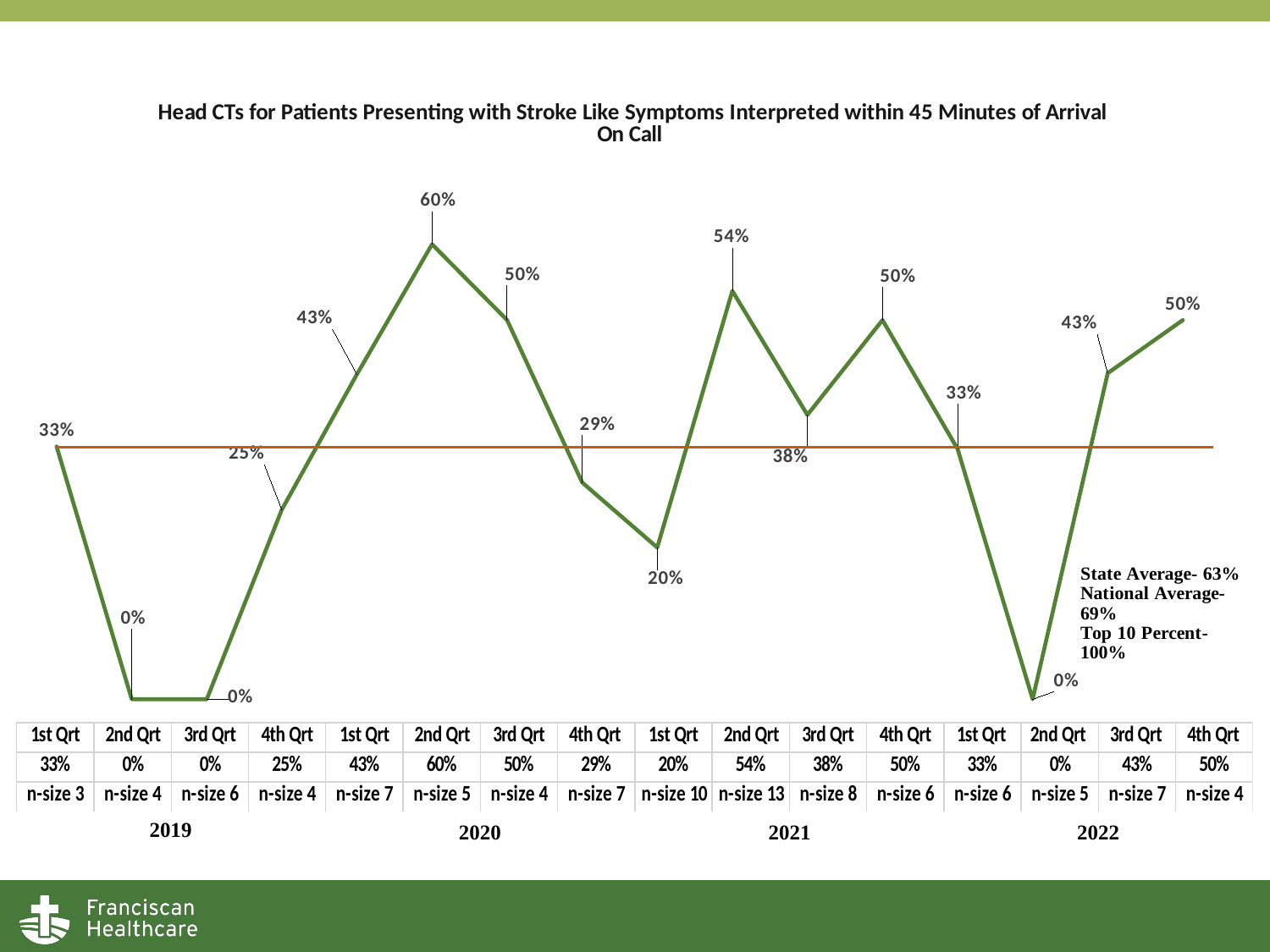
Which is larger, the value for the 4th Qrt of 2019 or the value for the 4th Qrt of 2020? 4th Qrt of 2020 What type of chart is shown on the slide? line chart Do the values rise or fall from the 1st Qrt of 2020 to the 2nd Qrt of 2020? rise What is the n-size for the 2nd Qrt of 2021? n-size 13 Which quarter has the highest value on the chart? 2nd Qrt 2020 What is the value for the 3rd Qrt of 2022? 43% How many quarterly data points are plotted on the chart? 16 What is the State Average shown in the text box on the chart? 63% What is the value for the 2nd Qrt of 2020? 60% What is the difference between the 2nd Qrt 2021 value and the 3rd Qrt 2021 value? 16% What is the title of the chart? Head CTs for Patients Presenting with Stroke Like Symptoms Interpreted within 45 Minutes of Arrival On Call What is the value for the 1st Qrt of 2021? 20%